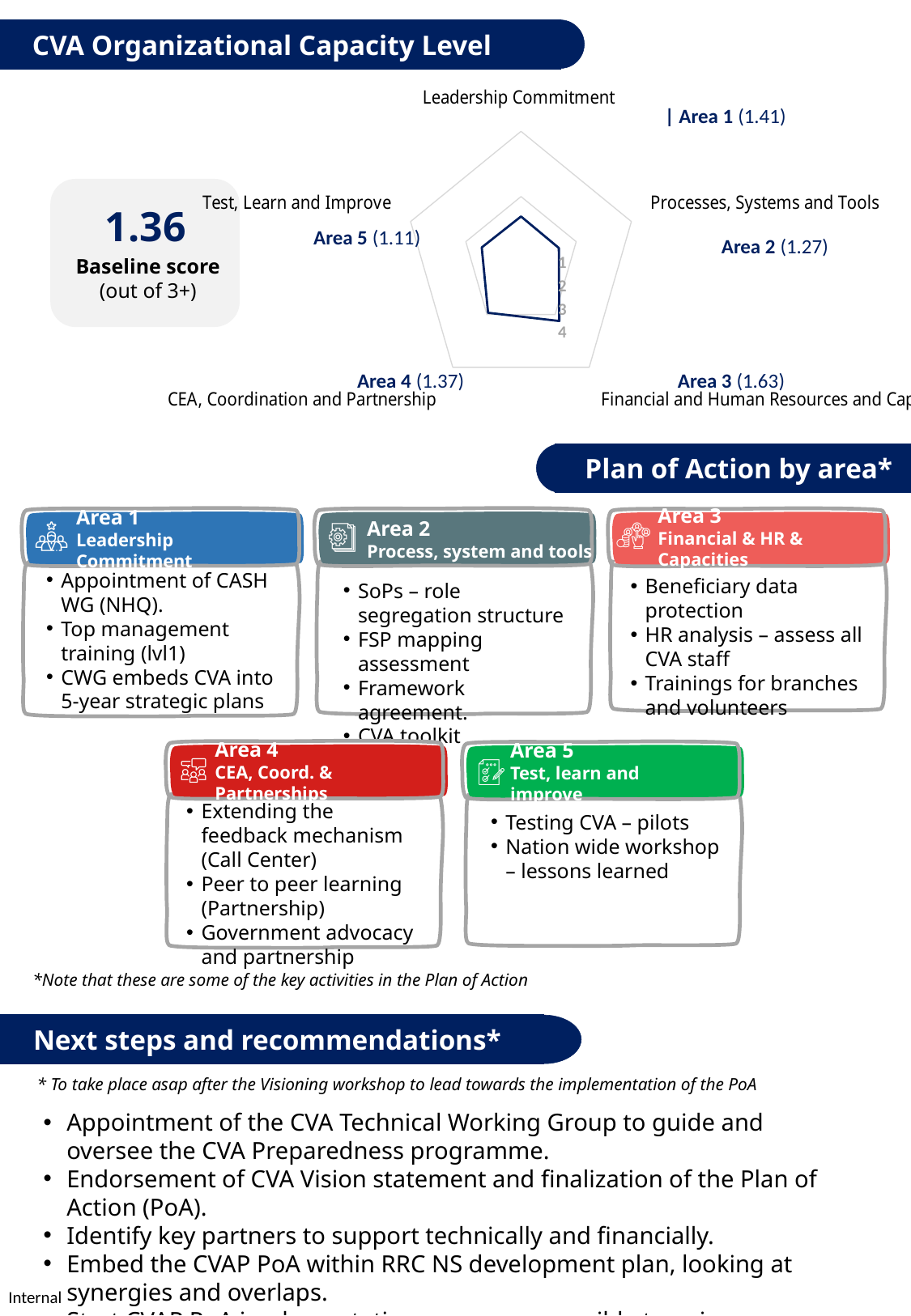
What is the difference between the scores of Area 3 and Area 5 on the radar chart? 0.52 Which has a higher score on the radar chart, Area 1 or Area 4? Area 1 Which area has the highest score on the radar chart? Area 3 (Financial and Human Resources and Capacities) What is the value for Area 2 (Processes, Systems and Tools) on the radar chart? 1.27 What is the value for Area 1 (Leadership Commitment) on the radar chart? 1.41 What is the value for Area 5 (Test, Learn and Improve) on the radar chart? 1.11 What is the value for Area 3 (Financial and Human Resources and Capacities) on the radar chart? 1.63 How many areas are plotted on the radar chart? 5 What is the baseline score shown next to the radar chart? 1.36 What kind of chart is used to show the CVA Organizational Capacity Level? Radar chart Which area has the lowest score on the radar chart? Area 5 (Test, Learn and Improve)